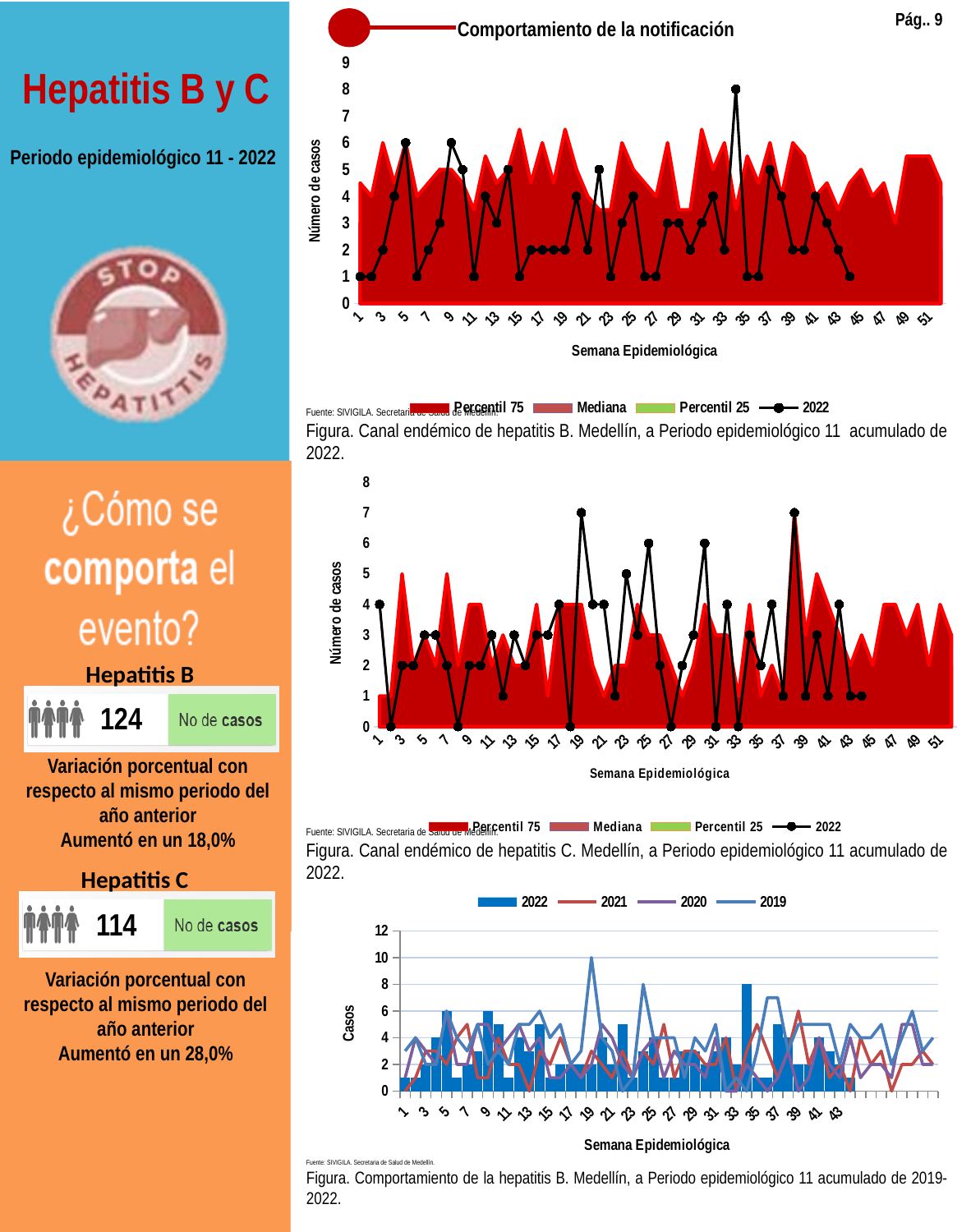
In the middle chart (canal endémico de hepatitis C), what is the lowest value reached by the 2022 line? 0 In the bottom chart (comportamiento de la hepatitis B 2019-2022), which series is drawn as bars rather than a line? 2022 In the middle chart (canal endémico de hepatitis C), what is the 2022 value at week 19? 7 In the bottom chart (comportamiento de la hepatitis B 2019-2022), is the 2019 value at week 19 greater or less than 8? greater In the middle chart (canal endémico de hepatitis C), what is the 2022 value at week 1? 4 In the top chart (canal endémico de hepatitis B), how many series does the legend list? 4 In the top chart (canal endémico de hepatitis B), what is the highest value reached by the 2022 line? 8 In the top chart (canal endémico de hepatitis B), what is the 2022 value at week 1? 1 In the middle chart (canal endémico de hepatitis C), what is the highest value reached by the 2022 line? 7 In the top chart (canal endémico de hepatitis B), which is larger for 2022: the value at week 1 or the value at week 5? week 5 In the top chart (canal endémico de hepatitis B), what is the label of the vertical axis? Número de casos In the bottom chart (comportamiento de la hepatitis B 2019-2022), how many series does the legend list? 4